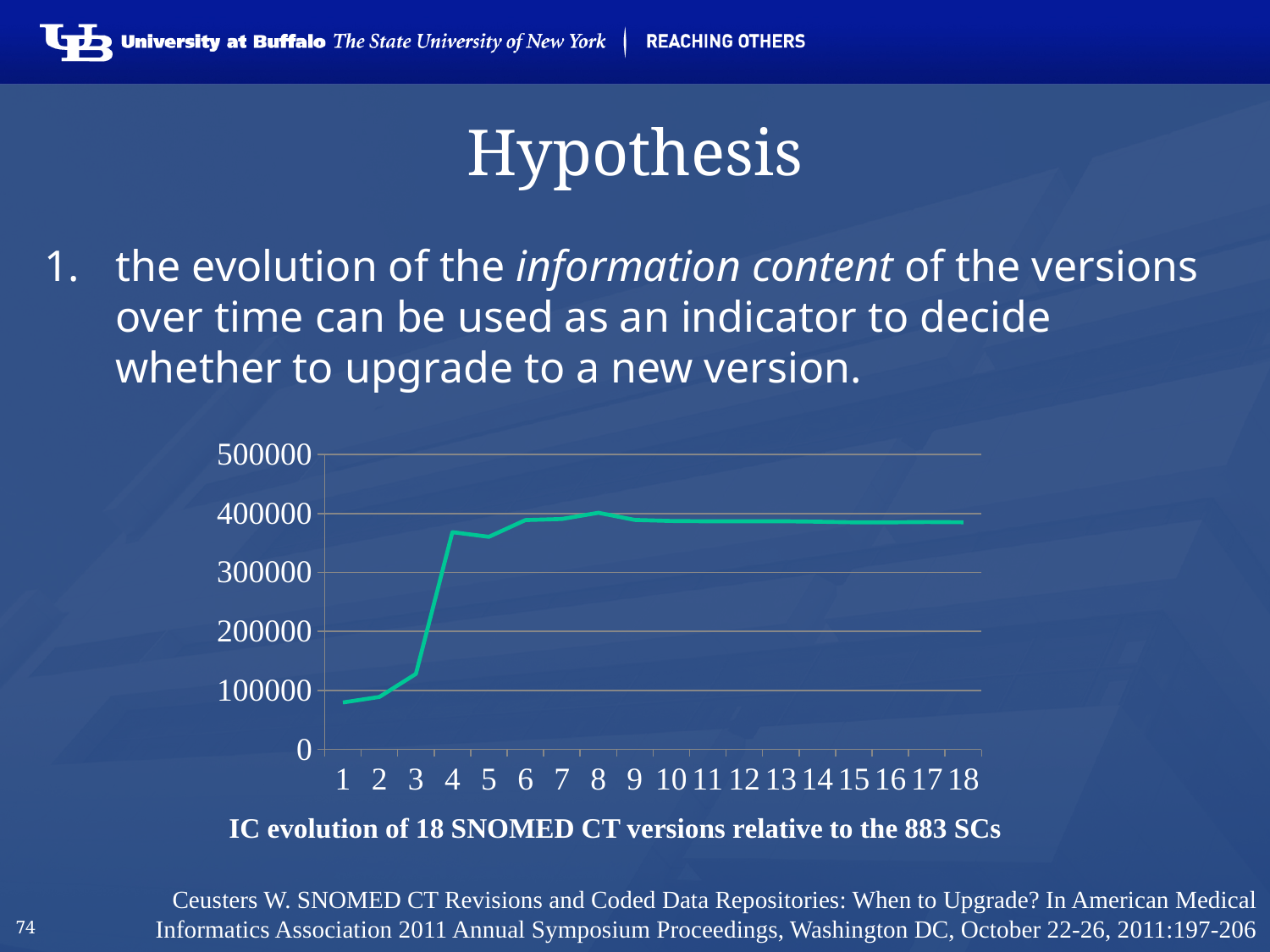
Is the value for version 4 greater or less than 300000? greater What is the caption printed below the chart? IC evolution of 18 SNOMED CT versions relative to the 883 SCs What kind of chart is shown on the slide? line chart Which has the larger value, version 1 or version 4? version 4 Do the values generally rise or fall from version 1 to version 4? rise Is the value for version 1 greater or less than 100000? less Is the value for version 3 greater or less than 200000? less Which version has the lowest information content value in the chart? 1 How many versions (points) are plotted along the x axis of the chart? 18 Which has the larger value, version 3 or version 10? version 10